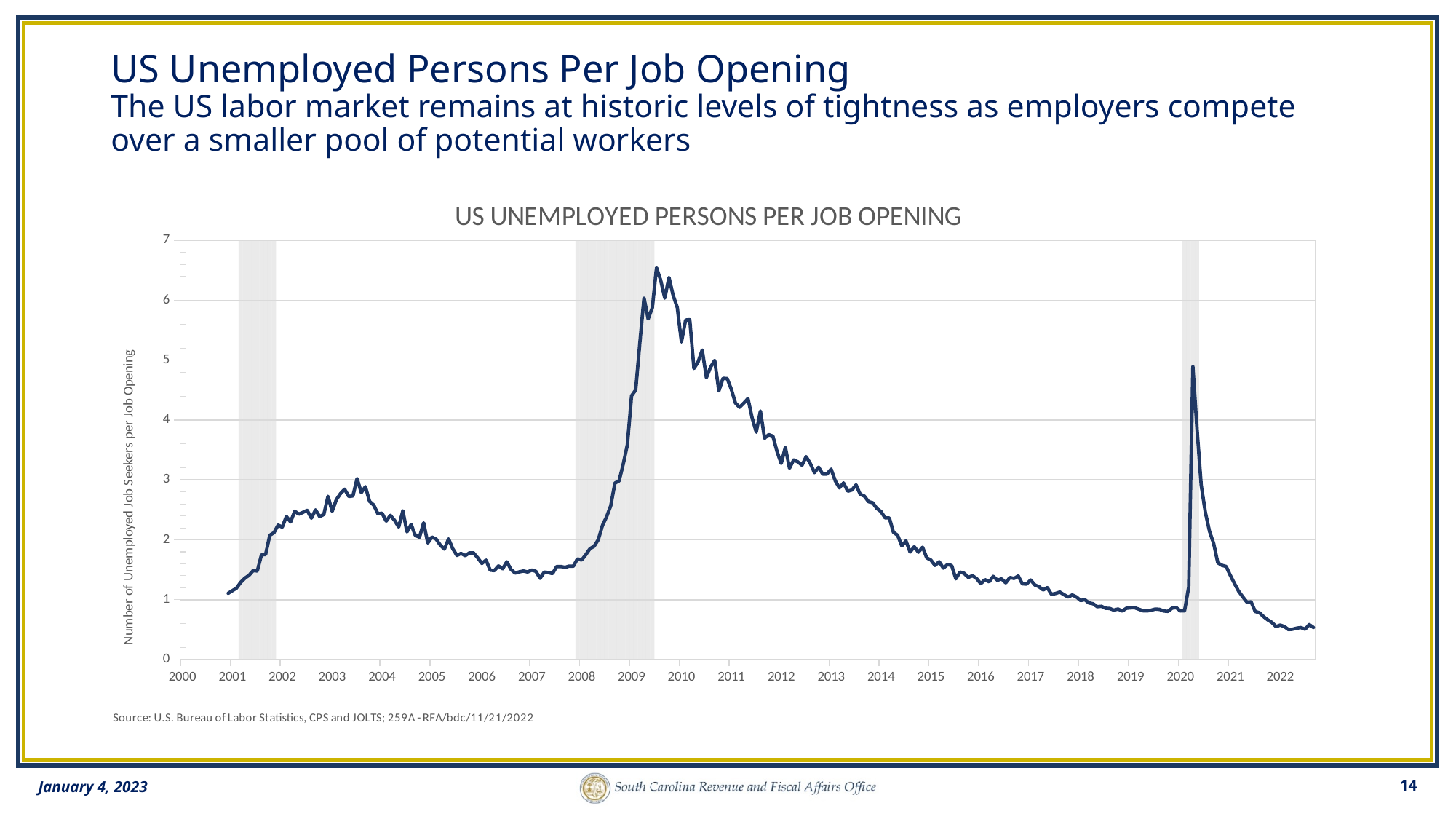
Which is higher, the peak of the line around 2009 or the spike in 2020? the peak around 2009 What is the title printed above the chart? US UNEMPLOYED PERSONS PER JOB OPENING Is the value of the line at the start of 2001 greater or less than 2? less What kind of chart is shown on the slide? line chart Is the value of the line at the end of 2022 greater or less than 1? less How many shaded vertical bands appear on the chart? 3 In which year does the line reach its highest value? 2009 Is the peak value of the line around 2009 greater or less than 6? greater Does the line rise or fall between 2010 and 2019? fall Does the line rise or fall between 2001 and 2003? rise